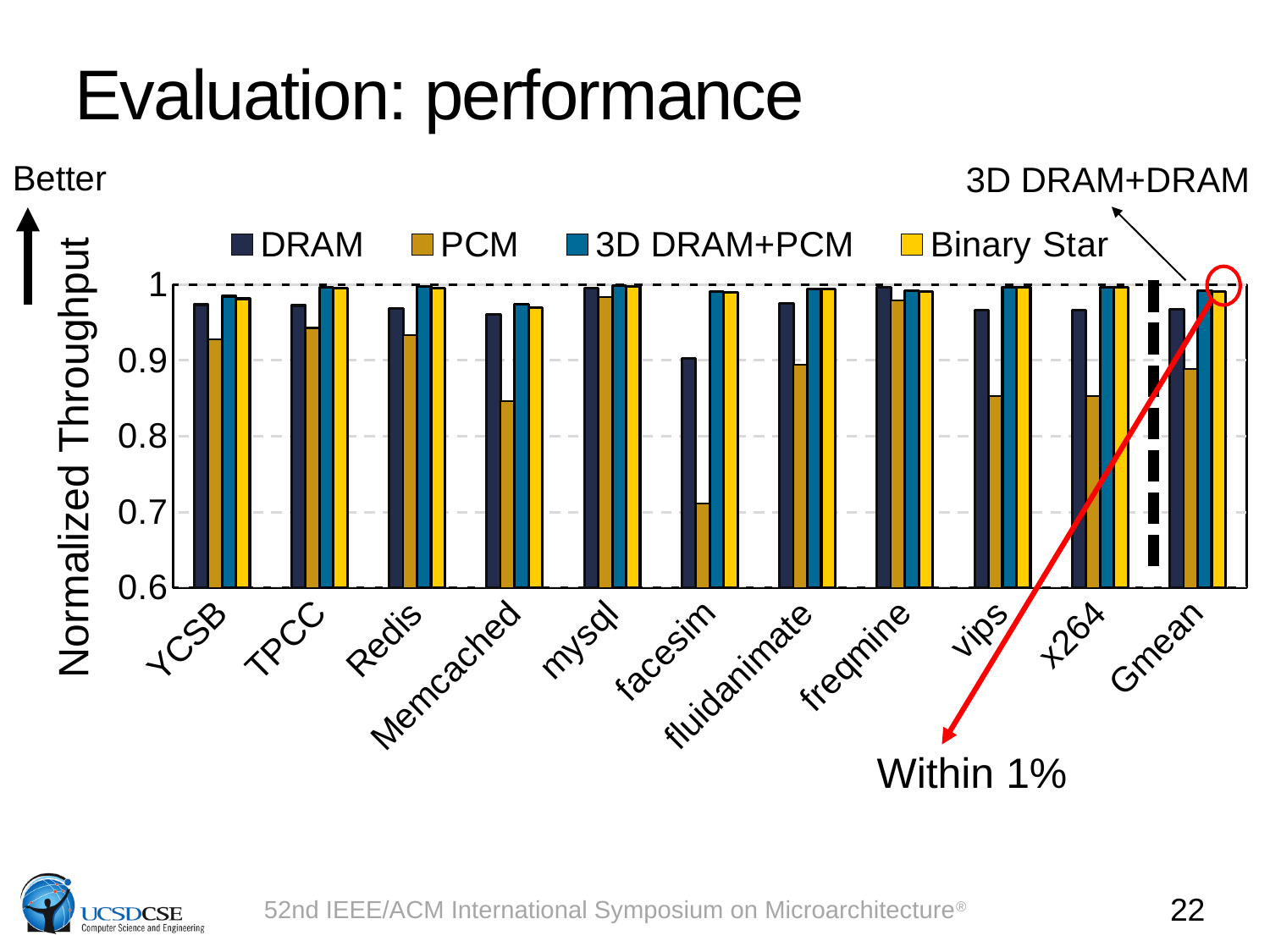
What is the label of the y axis? Normalized Throughput Is the PCM value for vips greater or less than 0.9? less Is the PCM value for Memcached greater or less than 0.9? less Is the DRAM value for TPCC greater or less than 0.9? greater Which series is shown in yellow in the legend? Binary Star How many categories are shown on the x axis? 11 For facesim, which is larger: the DRAM value or the PCM value? DRAM For which category is the PCM bar the lowest? facesim How many series does the legend list? 4 What kind of chart is shown on the slide? bar chart